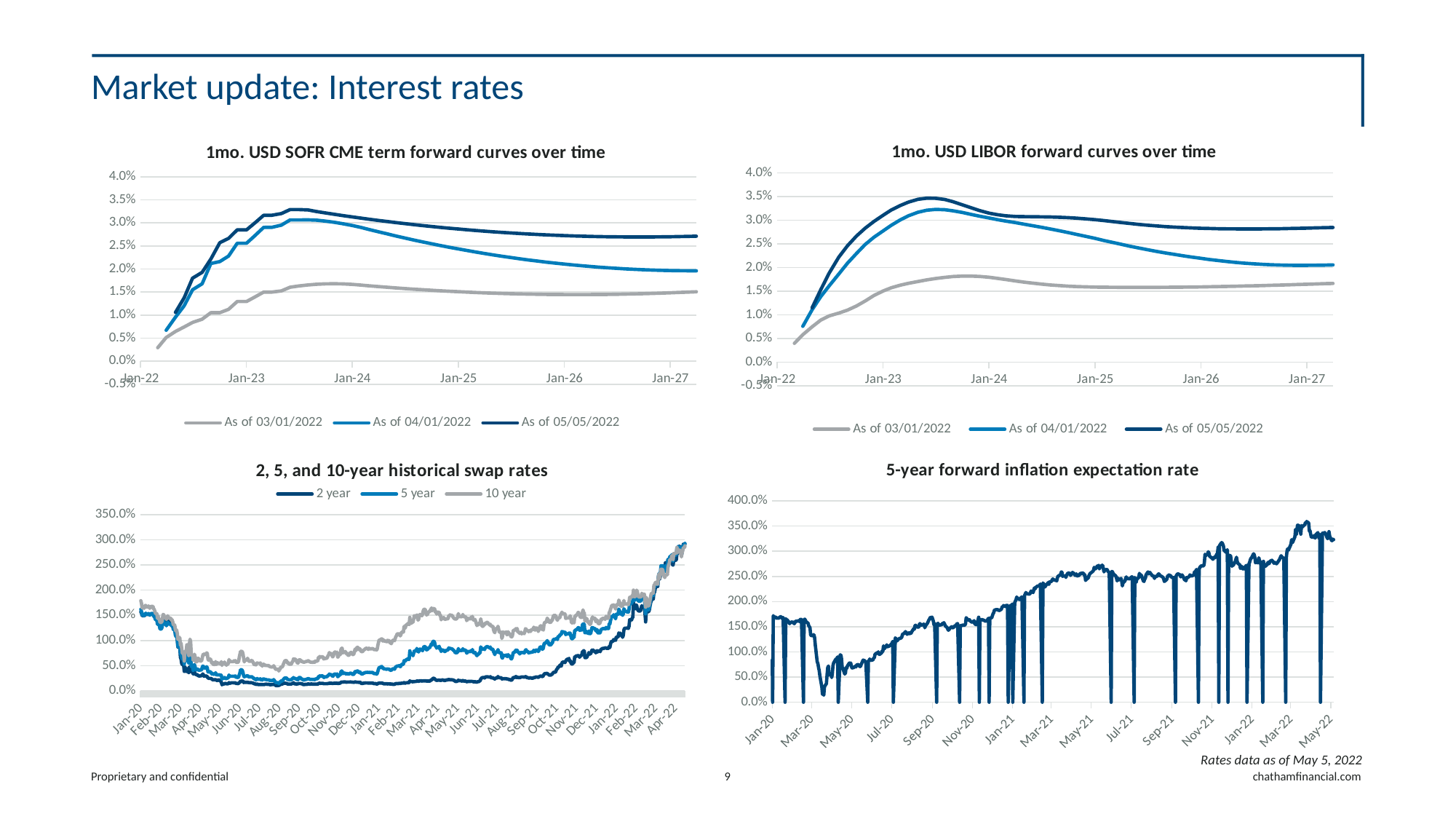
In the '5-year forward inflation expectation rate' chart, is the highest value reached greater or less than 300.0%? greater What kind of chart is the '1mo. USD SOFR CME term forward curves over time' chart? line chart In the '1mo. USD SOFR CME term forward curves over time' chart, which series sits highest across the chart? As of 05/05/2022 According to the note at the bottom right of the slide, as of what date is the rates data? May 5, 2022 How many series does the legend of the '1mo. USD LIBOR forward curves over time' chart list? 3 How many series are plotted in the '5-year forward inflation expectation rate' chart? 1 In the '1mo. USD LIBOR forward curves over time' chart, which is larger at Jan-24: the 'As of 04/01/2022' curve or the 'As of 03/01/2022' curve? As of 04/01/2022 What are the three series listed in the legend of the '2, 5, and 10-year historical swap rates' chart? 2 year, 5 year, 10 year In the '2, 5, and 10-year historical swap rates' chart, do the swap rates rise or fall between Sep-21 and Apr-22? rise In the '1mo. USD LIBOR forward curves over time' chart, is the value of the 'As of 03/01/2022' curve at Jan-27 greater or less than 2.0%? less In the '1mo. USD LIBOR forward curves over time' chart, which series sits lowest across the chart? As of 03/01/2022 In the '1mo. USD SOFR CME term forward curves over time' chart, is the peak value of the 'As of 05/05/2022' curve greater or less than 3.0%? greater